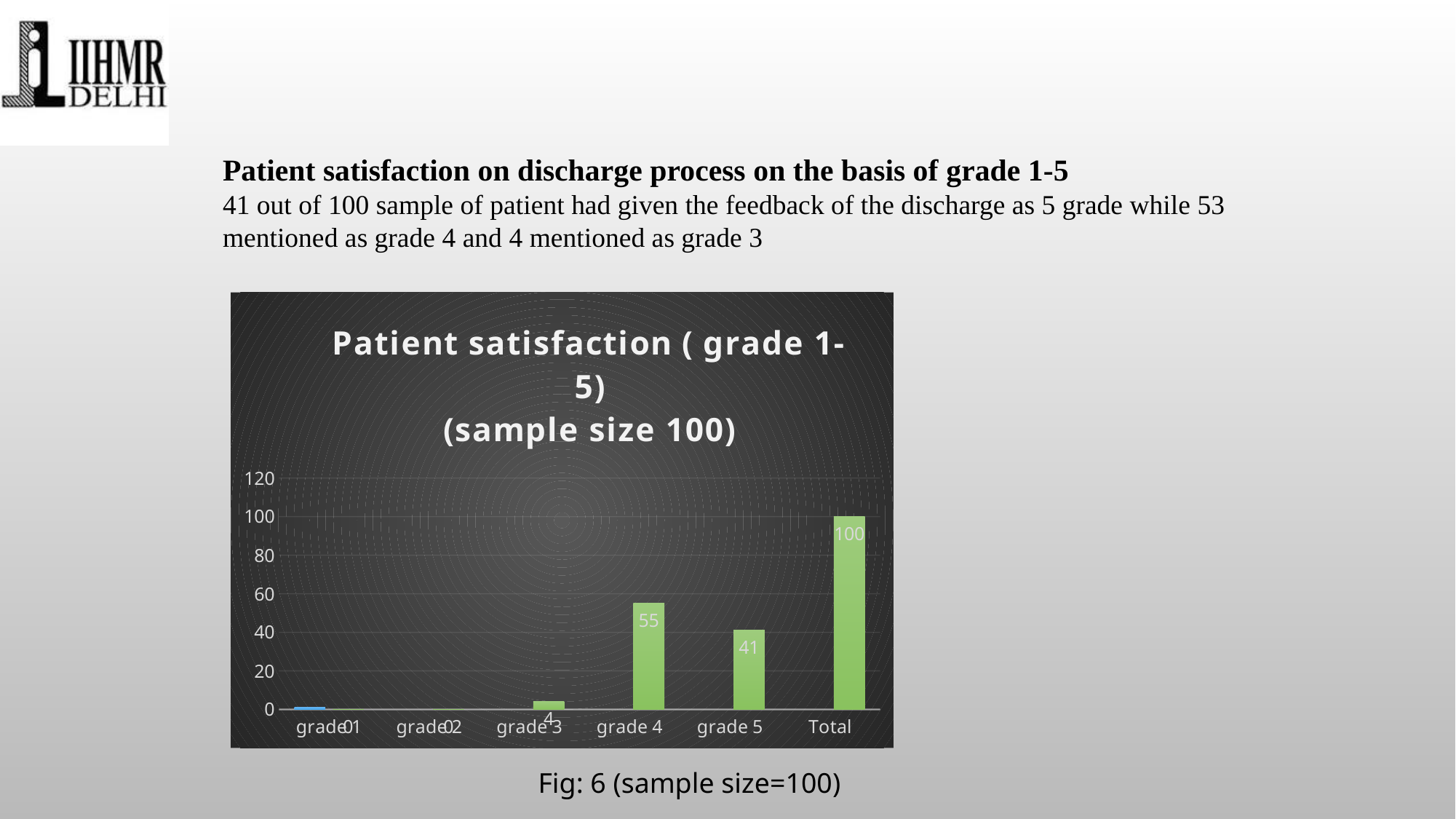
Which is larger, the value for grade 4 or the value for grade 5? grade 4 Which grade category (excluding Total) has the highest value? grade 4 What is the title of the chart? Patient satisfaction ( grade 1-5) (sample size 100) How many categories are shown on the x axis of the chart? 6 What is the value for grade 3 in the chart? 4 What is the value for grade 4 in the chart? 55 What is the highest value shown on the vertical axis of the chart? 120 What is the difference between the values for grade 4 and grade 5? 14 What is the value for grade 5 in the chart? 41 What is the value for Total in the chart? 100 What kind of chart is shown on the slide? bar chart Is the value for grade 5 greater or less than 60? less